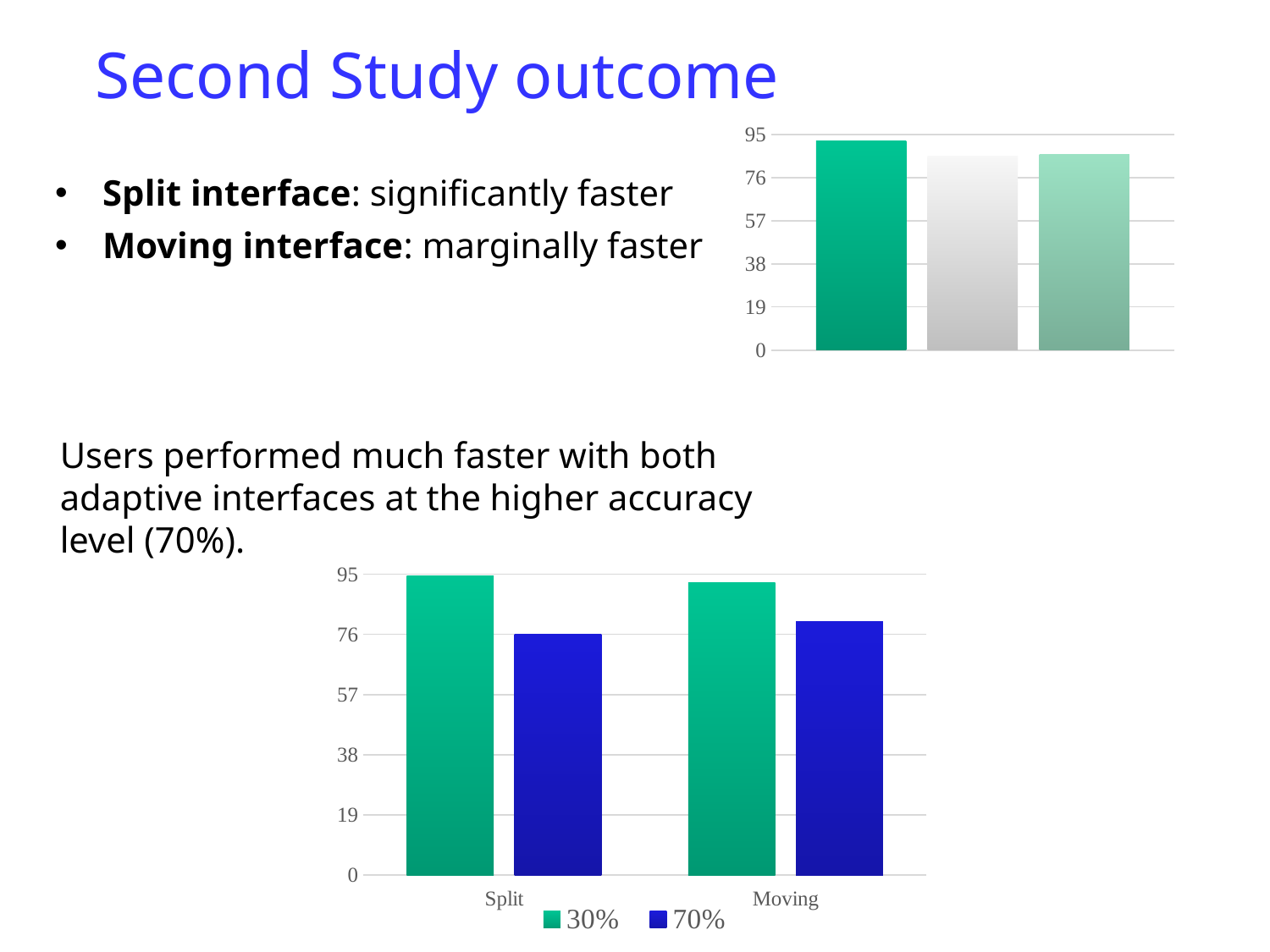
In the bottom chart, what are the two legend entries? 30% and 70% In the bottom chart, how many categories are shown on the x axis? 2 In the bottom chart, is the 70% value for Split greater or less than 57? greater In the top-right chart, is the value of the first (leftmost) bar greater or less than 76? greater In the bottom chart, how many series does the legend list? 2 What type of chart is the bottom chart with the Split and Moving categories? bar chart In the bottom chart, which series is larger for Moving, 30% or 70%? 30% How many bars are in the top-right chart? 3 In the bottom chart, which bar is the lowest? Split, 70% In the bottom chart, which category has the larger 70% value, Split or Moving? Moving In the bottom chart, which series is larger for Split, 30% or 70%? 30% In the bottom chart, is the 30% value for Moving greater or less than 76? greater